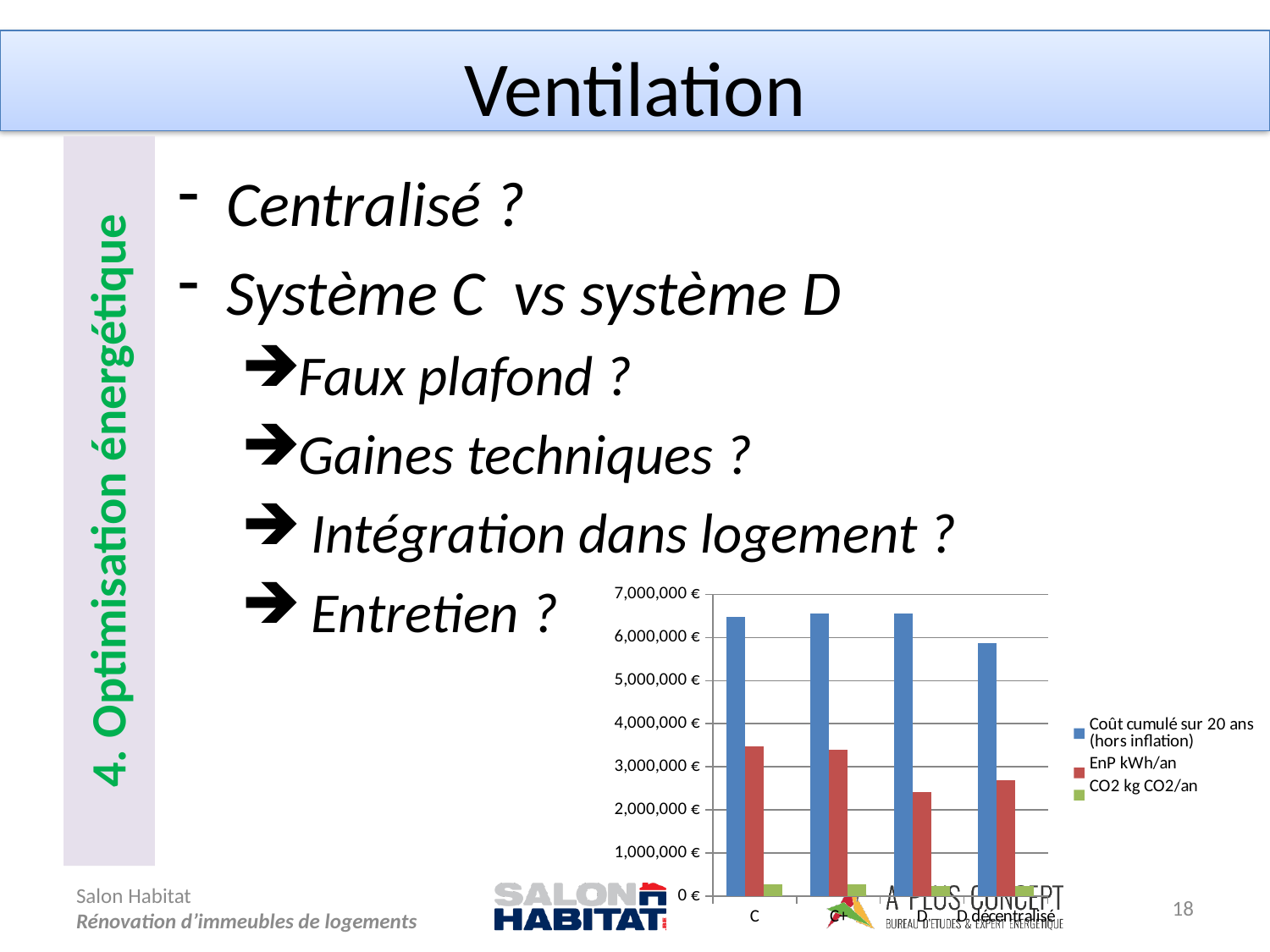
Is the value of 'Coût cumulé sur 20 ans (hors inflation)' for D décentralisé greater or less than 6,000,000 €? less How many categories are shown on the x axis of the chart? 4 Which category has the lowest value for 'EnP kWh/an'? D Which is larger: the 'EnP kWh/an' value for C+ or for D? C+ What kind of chart is shown on the slide? bar chart Is the value of 'Coût cumulé sur 20 ans (hors inflation)' for C greater or less than 6,000,000 €? greater Is the value of 'EnP kWh/an' for D greater or less than 3,000,000 €? less Which is larger: the 'Coût cumulé sur 20 ans (hors inflation)' value for C or for D décentralisé? C Which series is shown in green in the chart? CO2 kg CO2/an Which category has the lowest value for 'Coût cumulé sur 20 ans (hors inflation)'? D décentralisé How many series does the chart legend list? 3